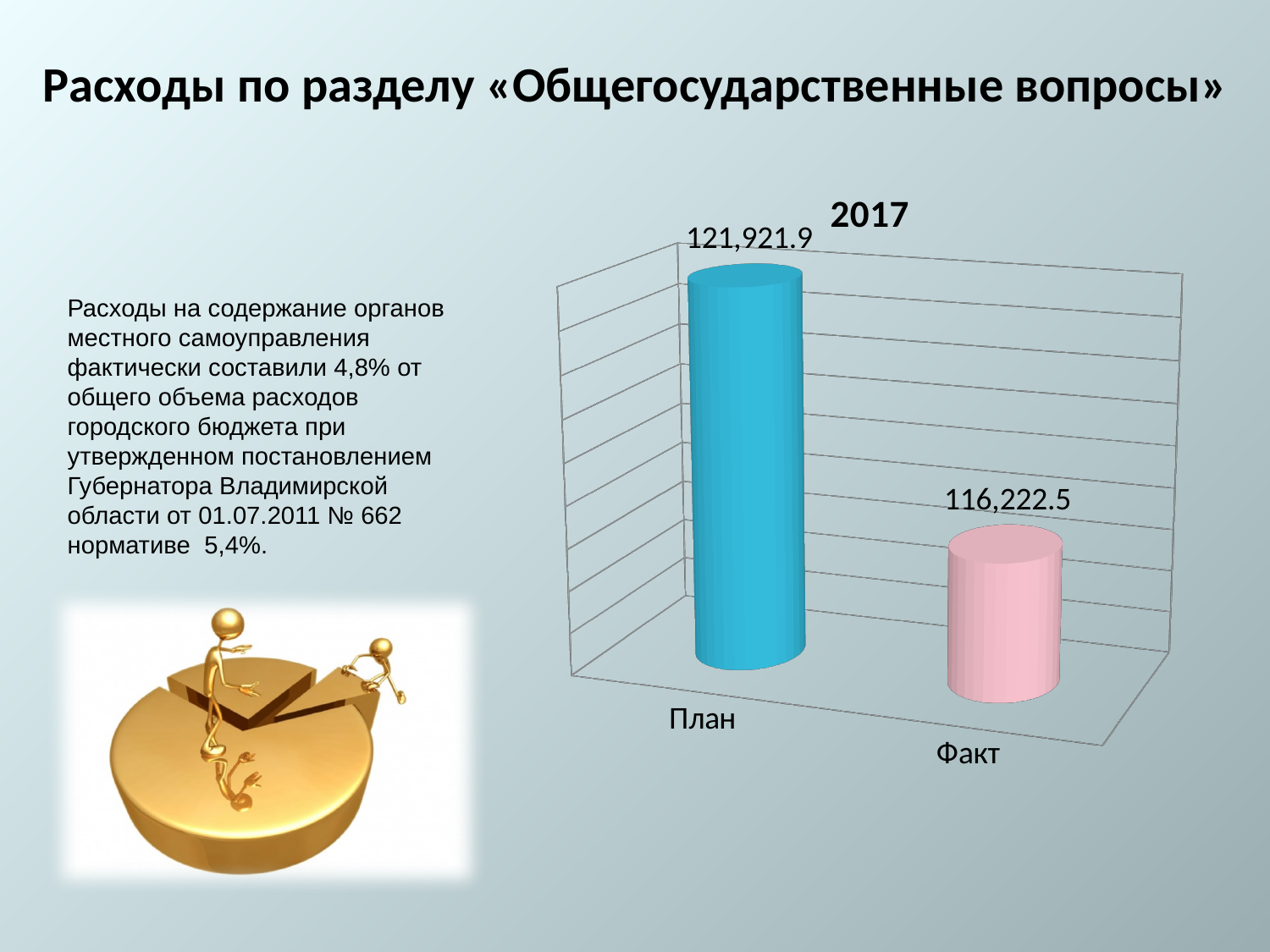
What kind of chart is shown on the slide? Bar chart What is the value for План in the chart? 121,921.9 Do the values rise or fall from План to Факт? Fall What is the difference between the План and Факт values? 5,699.4 Which is larger, the value for План or the value for Факт? План What colour is the bar for Факт? Pink Which category has the lowest value in the chart? Факт What is the value for Факт in the chart? 116,222.5 Which category has the highest value in the chart? План How many categories are shown in the chart? 2 What is the title of the chart? 2017